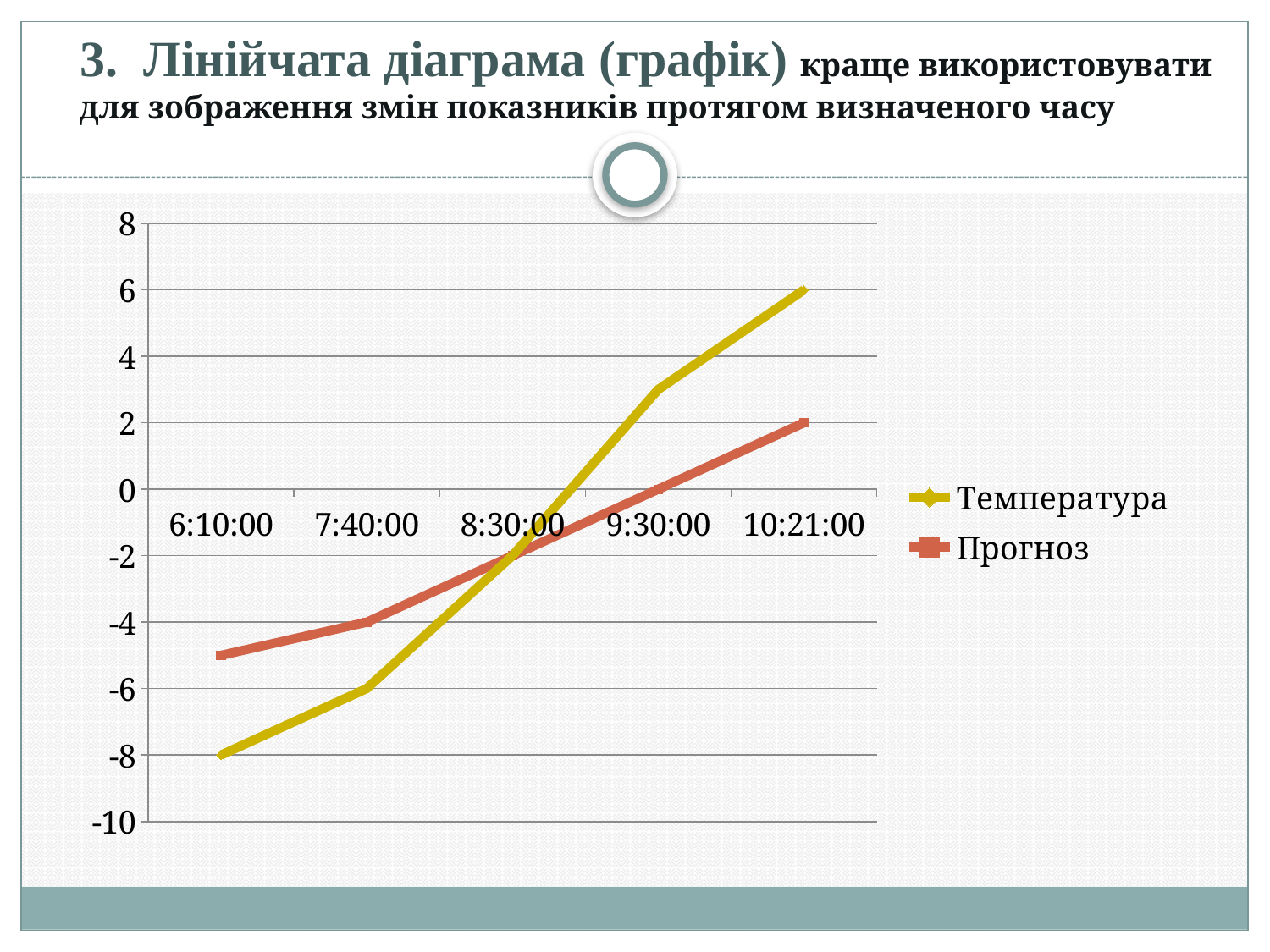
How many time points are plotted along the x axis? 5 What is the value of Температура at 10:21:00? 6 What is the value of Температура at 6:10:00? -8 At which time is the Температура value lowest? 6:10:00 Which series has the larger value at 6:10:00, Температура or Прогноз? Прогноз What is the difference between Температура and Прогноз at 10:21:00? 4 How many series does the legend list? 2 What is the value of Прогноз at 10:21:00? 2 What is the value of Прогноз at 9:30:00? 0 Do the Температура values rise or fall from 6:10:00 to 10:21:00? rise At which time is the Прогноз value highest? 10:21:00 What kind of chart is shown on the slide? line chart